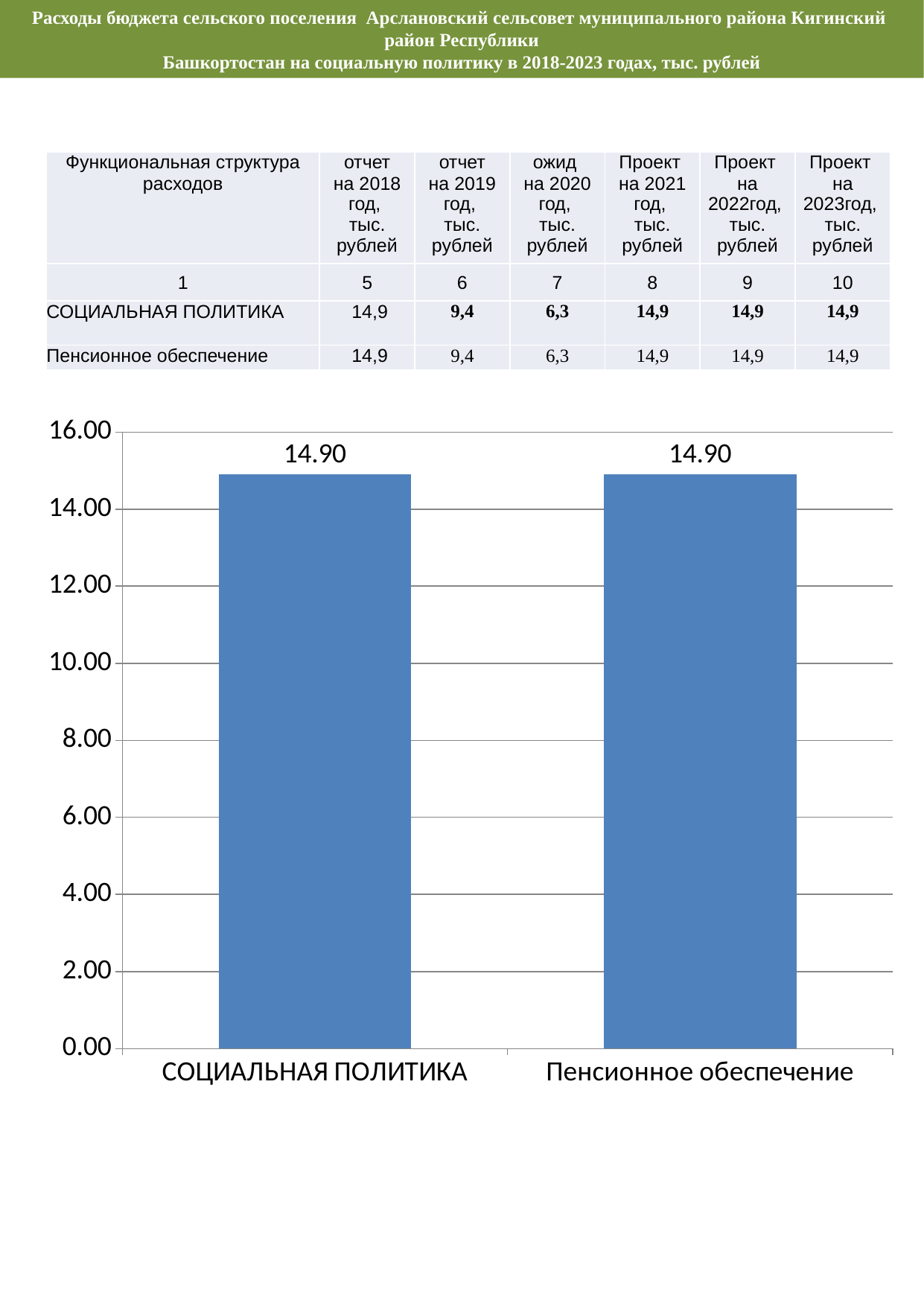
How many bars are plotted in the chart? 2 What kind of chart is shown on the slide? bar chart What is the highest tick value shown on the vertical axis of the chart? 16.00 What value is shown for Пенсионное обеспечение in the bar chart? 14.90 Is the value for Пенсионное обеспечение greater or less than 16.00? less Is the value for СОЦИАЛЬНАЯ ПОЛИТИКА greater or less than 14.00? greater Are the values for СОЦИАЛЬНАЯ ПОЛИТИКА and Пенсионное обеспечение in the chart equal? Yes What is the label of the first (left) bar in the chart? СОЦИАЛЬНАЯ ПОЛИТИКА What is the difference between the values for СОЦИАЛЬНАЯ ПОЛИТИКА and Пенсионное обеспечение in the bar chart? 0.00 What value is shown for СОЦИАЛЬНАЯ ПОЛИТИКА in the bar chart? 14.90